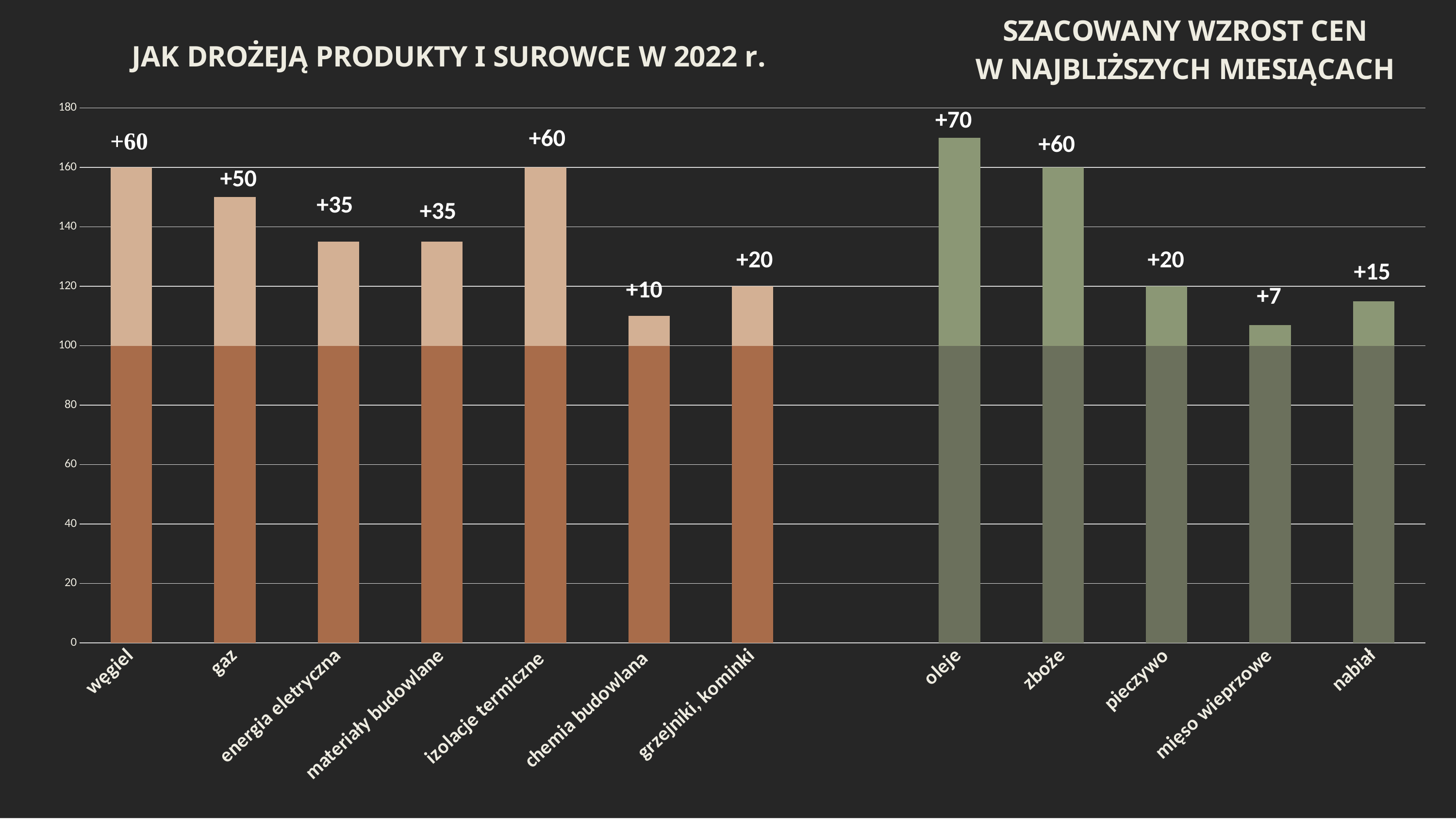
What is the difference between the labelled values for gaz and chemia budowlana? 40 What is the title above the brown bars on the left side of the slide? JAK DROŻEJĄ PRODUKTY I SUROWCE W 2022 r. What is the data label shown for nabiał? +15 Is the top of the bar for grzejniki, kominki greater or less than 140 on the y axis? less What kind of chart is shown on the slide? bar chart What is the difference between the labelled values for oleje and nabiał? 55 Among the brown bars on the left, which category has the lowest value? chemia budowlana How many categories are shown on the x axis in total? 12 What is the data label shown for węgiel? +60 Among the green bars on the right (oleje, zboże, pieczywo, mięso wieprzowe, nabiał), which category has the highest value? oleje Which has a larger value, zboże or pieczywo? zboże What is the data label shown for mięso wieprzowe? +7